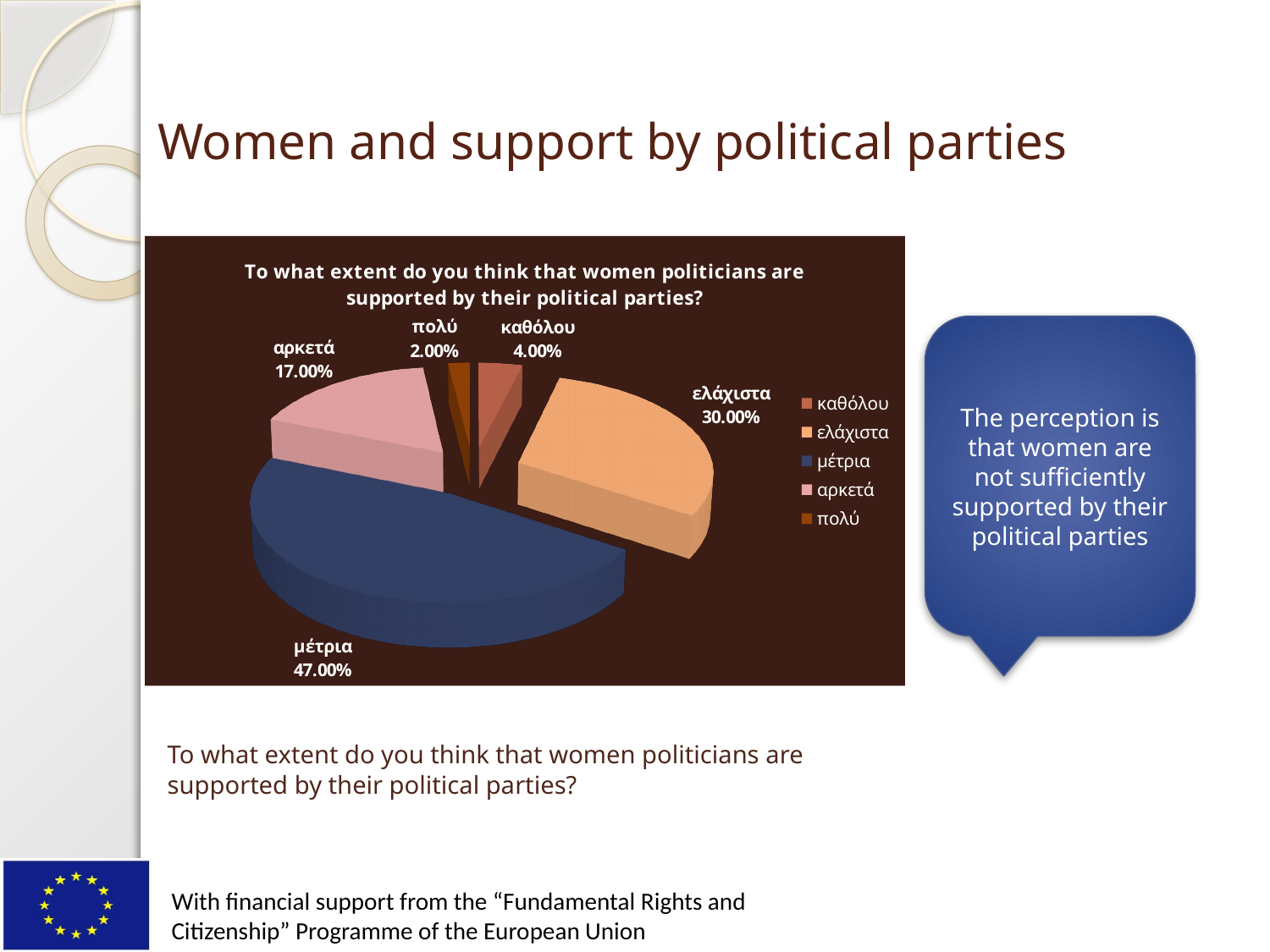
What is the value for ελάχιστα? 30.00% What is the value for αρκετά? 17.00% Which is larger, the value for αρκετά or the value for καθόλου? αρκετά What is the value for πολύ? 2.00% What kind of chart is shown on the slide? Pie chart What is the value for καθόλου? 4.00% Which category has the largest slice? μέτρια What is the difference between the values for μέτρια and ελάχιστα? 17.00% What is the title of the chart? To what extent do you think that women politicians are supported by their political parties? What is the value for μέτρια? 47.00% How many categories does the pie chart have? 5 Which category has the smallest slice? πολύ